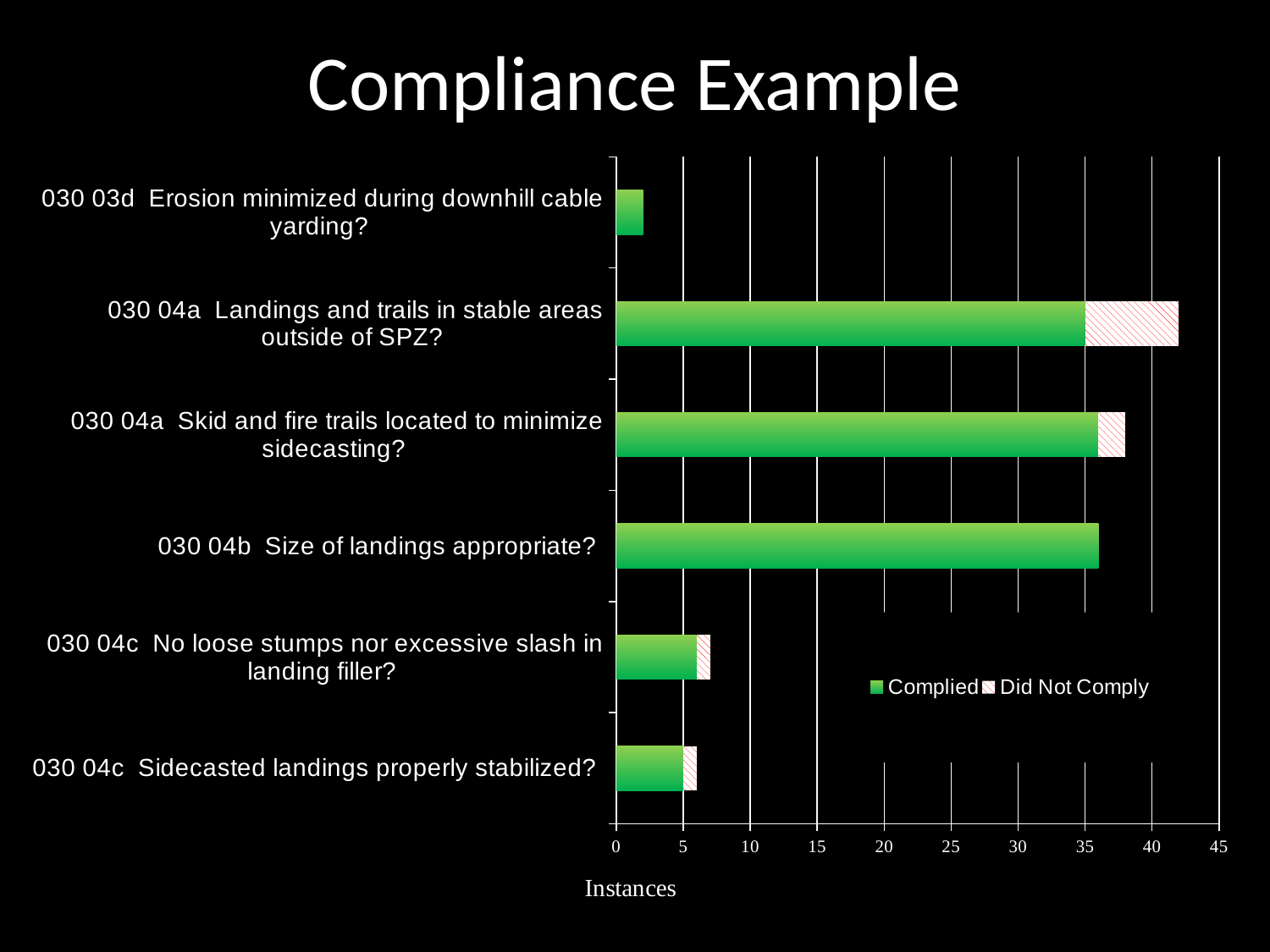
Which category has the largest 'Did Not Comply' segment? 030 04a Landings and trails in stable areas outside of SPZ? Is the 'Complied' value for '030 03d Erosion minimized during downhill cable yarding?' greater or less than 5? less Is the total bar length for '030 04a Landings and trails in stable areas outside of SPZ?' greater or less than 40? greater What kind of chart is shown on the slide? bar chart Which category has the longest total bar in the chart? 030 04a Landings and trails in stable areas outside of SPZ? Which has a longer total bar: '030 04b Size of landings appropriate?' or '030 04c Sidecasted landings properly stabilized?'? 030 04b Size of landings appropriate? Is the 'Complied' value for '030 04b Size of landings appropriate?' greater or less than 30? greater How many series does the chart's legend list? 2 How many categories (questions) are listed on the vertical axis of the chart? 6 What are the two legend entries in the chart? Complied, Did Not Comply What is the title of the horizontal axis of the chart? Instances Which category has the shortest total bar in the chart? 030 03d Erosion minimized during downhill cable yarding?